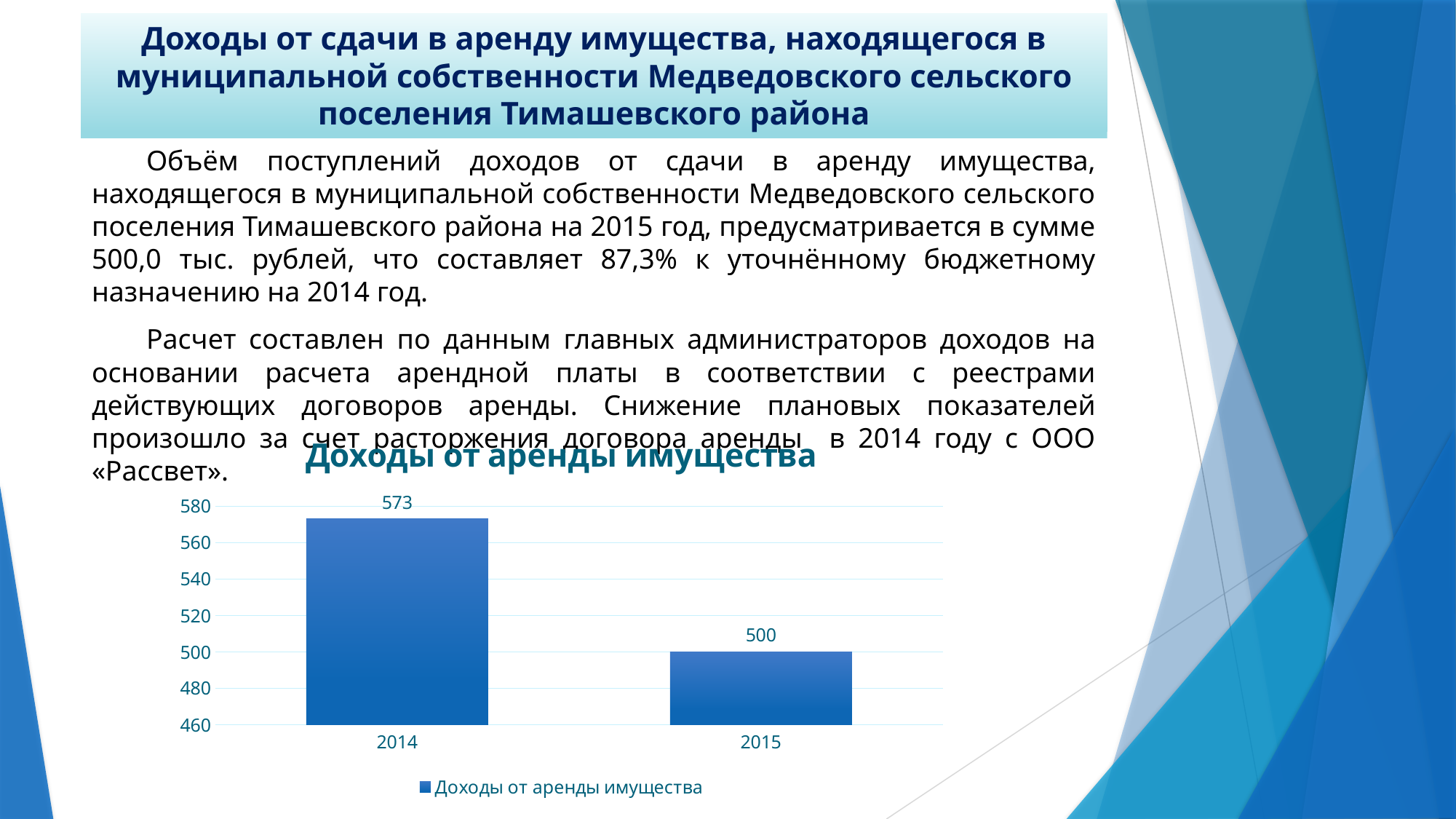
How many categories (years) are shown in the chart? 2 What is the value for 2015 in the chart? 500 What is the difference between the 2014 and 2015 values? 73 Which is larger, the value for 2014 or the value for 2015? 2014 Is the value for 2015 greater or less than 520? less What is the value for 2014 in the chart? 573 Which year has the lowest value in the chart? 2015 Is the value for 2014 greater or less than 560? greater What kind of chart is shown on the slide? bar chart Do the values rise or fall from 2014 to 2015? fall How many series does the legend list? 1 Which year has the highest value in the chart? 2014